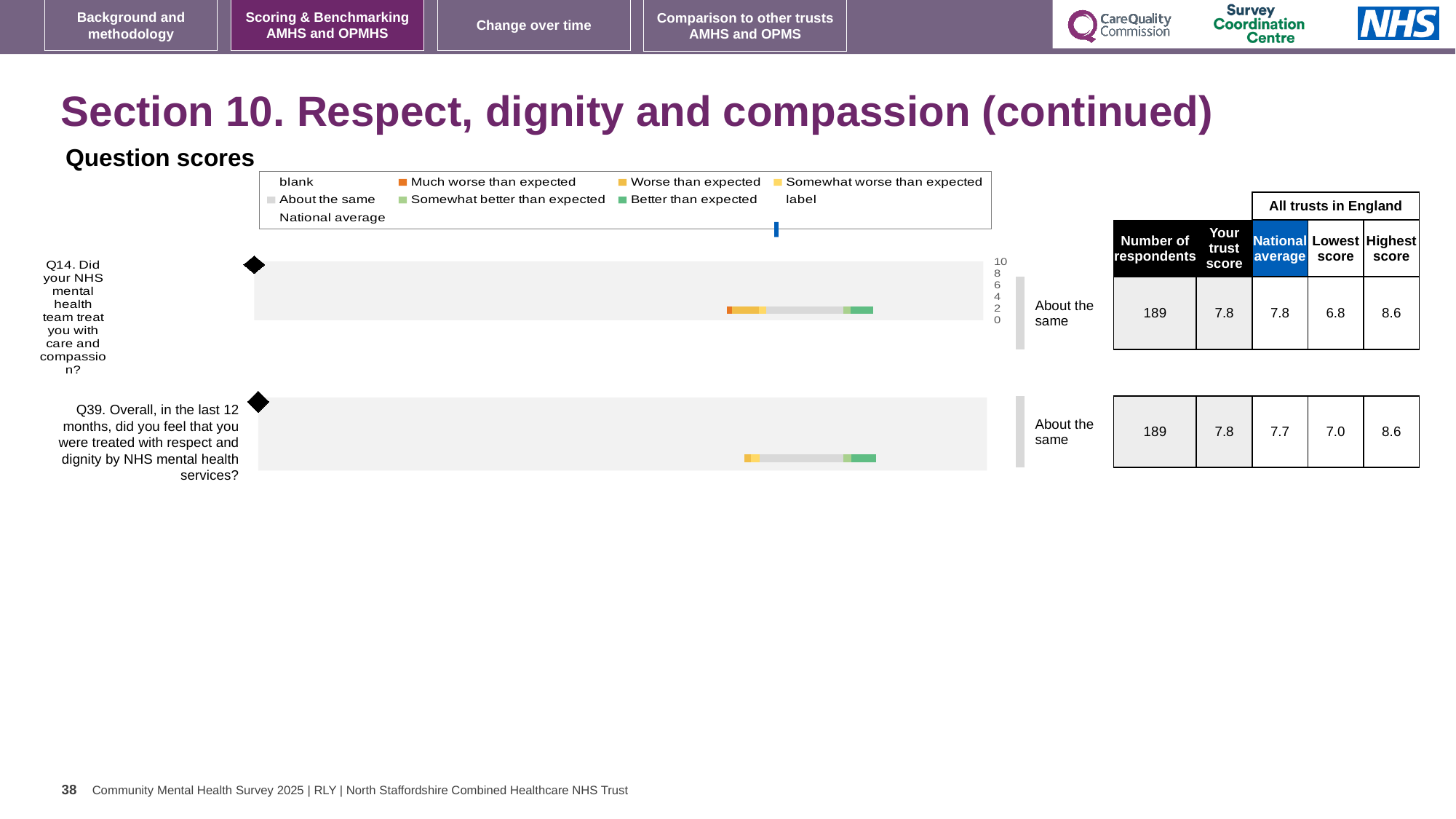
What is the national average score for Q39 (treated with respect and dignity by NHS mental health services)? 7.7 Which question has the higher lowest score across all trusts in England, Q14 or Q39? Q39 What is the difference between the trust score and the national average for Q39? 0.1 What benchmark category is shown next to the bar for Q14? About the same How many questions are plotted in the Question scores chart? 2 What is the trust score for Q14 (Did your NHS mental health team treat you with care and compassion?)? 7.8 What is the lowest score among all trusts in England for Q14? 6.8 How many respondents answered Q14? 189 What is the difference between the highest score and the lowest score for Q39? 1.6 Which legend entry is shown in orange? Much worse than expected What kind of chart is used to show the question scores? Bar chart What is the highest score among all trusts in England for Q39? 8.6